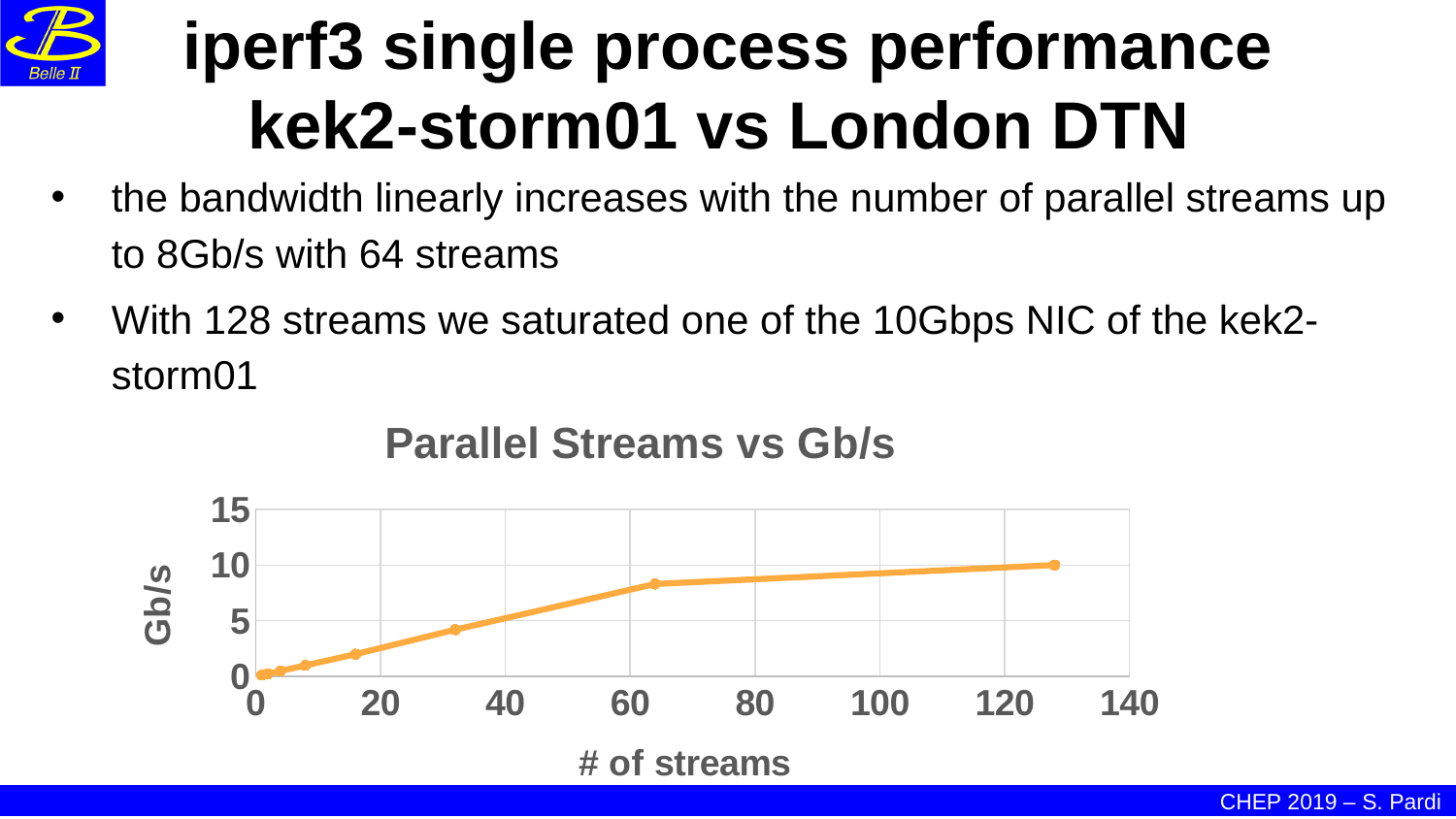
Which has the larger Gb/s value, 32 streams or 64 streams? 64 streams What kind of chart is shown on the slide? line chart What is the title of the chart? Parallel Streams vs Gb/s Is the value for 16 streams greater or less than 5 Gb/s? less Is the value for 32 streams greater or less than 5 Gb/s? less Is the value for 128 streams greater or less than 5 Gb/s? greater Do the values rise or fall as the number of streams increases along the x axis? rise Which has the larger Gb/s value, 64 streams or 128 streams? 128 streams What is the label of the vertical axis of the chart? Gb/s At which number of streams is the plotted Gb/s value highest? 128